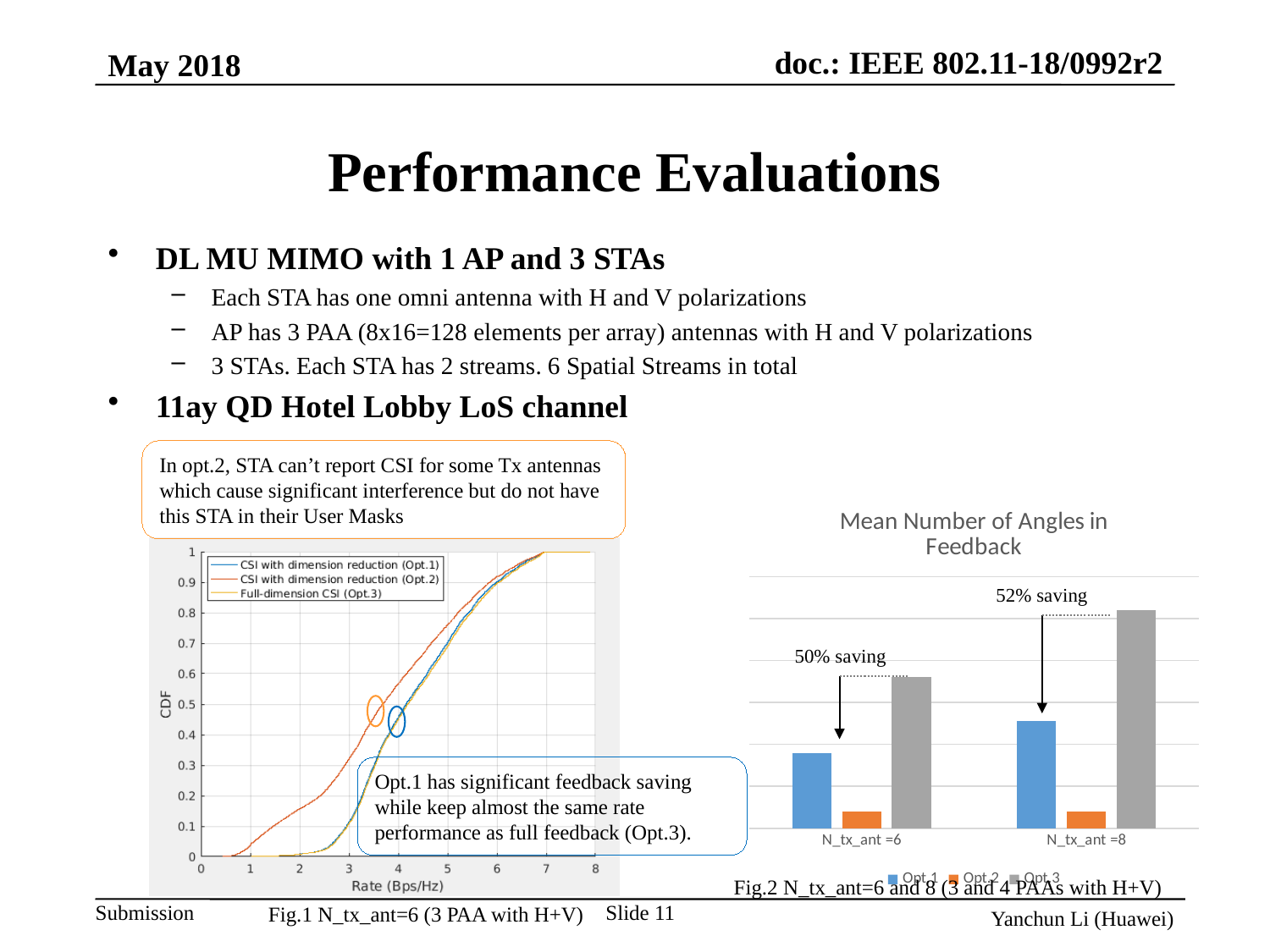
How many series does the legend of the CDF chart (Fig.1) list? 3 In the 'Mean Number of Angles in Feedback' chart, which option has the lowest bar for N_tx_ant =8? Opt.2 What is the x-axis label of the CDF chart (Fig.1)? Rate (Bps/Hz) In the 'Mean Number of Angles in Feedback' chart, which option has the highest bar for N_tx_ant =6? Opt.3 In the CDF chart (Fig.1), is the CDF value of the Opt.2 curve at a rate of 2 Bps/Hz greater or less than 0.5? less How many categories are shown on the x axis of the 'Mean Number of Angles in Feedback' chart? 2 In the 'Mean Number of Angles in Feedback' chart, what saving percentage is annotated for N_tx_ant =8? 52% saving What kind of chart is Fig.1 (the CDF chart on the left)? line chart In the 'Mean Number of Angles in Feedback' chart, is the Opt.1 bar larger for N_tx_ant =6 or N_tx_ant =8? N_tx_ant =8 In the 'Mean Number of Angles in Feedback' chart, does the Opt.3 value rise or fall from N_tx_ant =6 to N_tx_ant =8? rise What kind of chart is the 'Mean Number of Angles in Feedback' chart? bar chart How many series does the legend of the 'Mean Number of Angles in Feedback' chart list? 3